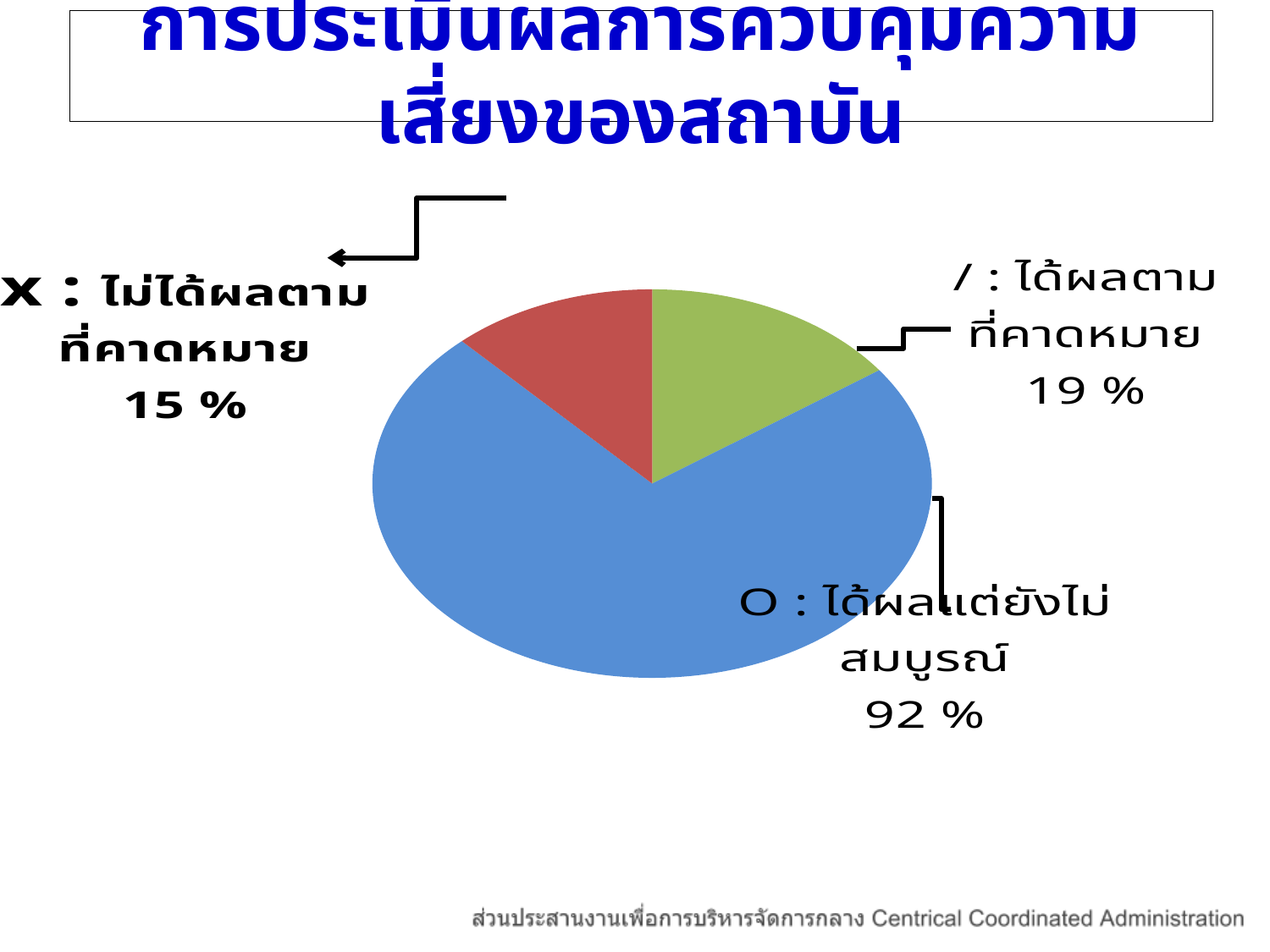
Which category has the smallest slice of the pie? X : ไม่ได้ผลตามที่คาดหมาย What kind of chart is shown on the slide? Pie chart Which category has the largest slice of the pie? O : ได้ผลแต่ยังไม่สมบูรณ์ What colour is the slice labelled "X : ไม่ได้ผลตามที่คาดหมาย"? Red What is the difference between the percentage for "/ : ได้ผลตามที่คาดหมาย" and the percentage for "X : ไม่ได้ผลตามที่คาดหมาย"? 4 % What share of the pie is labelled "X : ไม่ได้ผลตามที่คาดหมาย"? 15 % What percentage is shown for the slice labelled "/ : ได้ผลตามที่คาดหมาย"? 19 % What percentage is shown for the slice labelled "O : ได้ผลแต่ยังไม่สมบูรณ์"? 92 % What is the difference between the percentage for "O : ได้ผลแต่ยังไม่สมบูรณ์" and the percentage for "/ : ได้ผลตามที่คาดหมาย"? 73 % Which is larger: the slice for "/ : ได้ผลตามที่คาดหมาย" or the slice for "X : ไม่ได้ผลตามที่คาดหมาย"? / : ได้ผลตามที่คาดหมาย How many slices does the pie chart have? 3 What colour is the largest slice of the pie chart? Blue